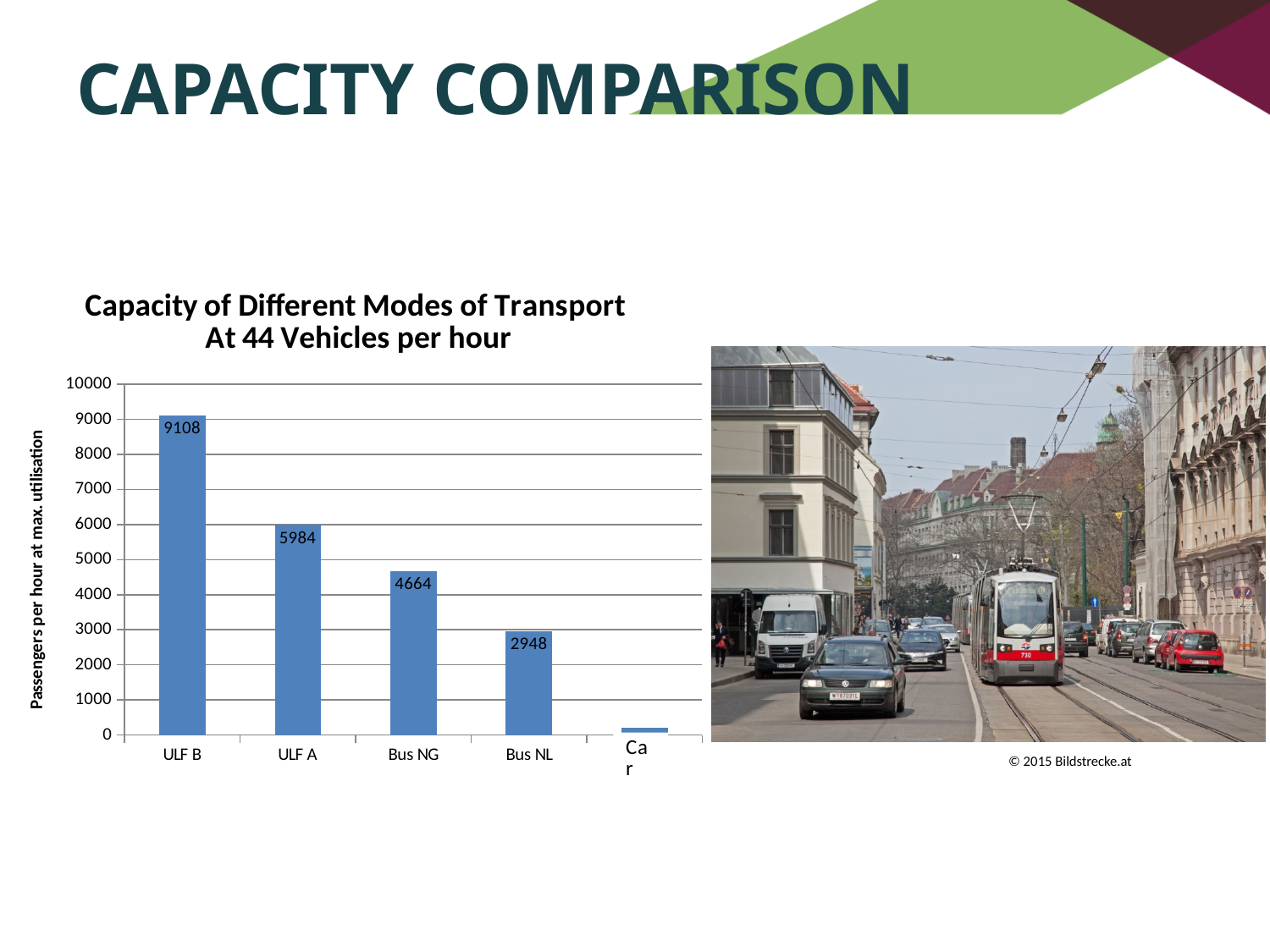
What is the value for Bus NG? 4664 What is the value for ULF B? 9108 What kind of chart is shown? bar chart What is the value for Bus NL? 2948 Which is larger, the value for ULF A or the value for Bus NG? ULF A Which category has the lowest value? Car What is the value for ULF A? 5984 What is the difference between the values for ULF B and ULF A? 3124 How many categories are shown on the x axis? 5 What is the difference between the values for Bus NG and Bus NL? 1716 Which category has the highest value? ULF B Is the value for Car greater or less than 1000? less